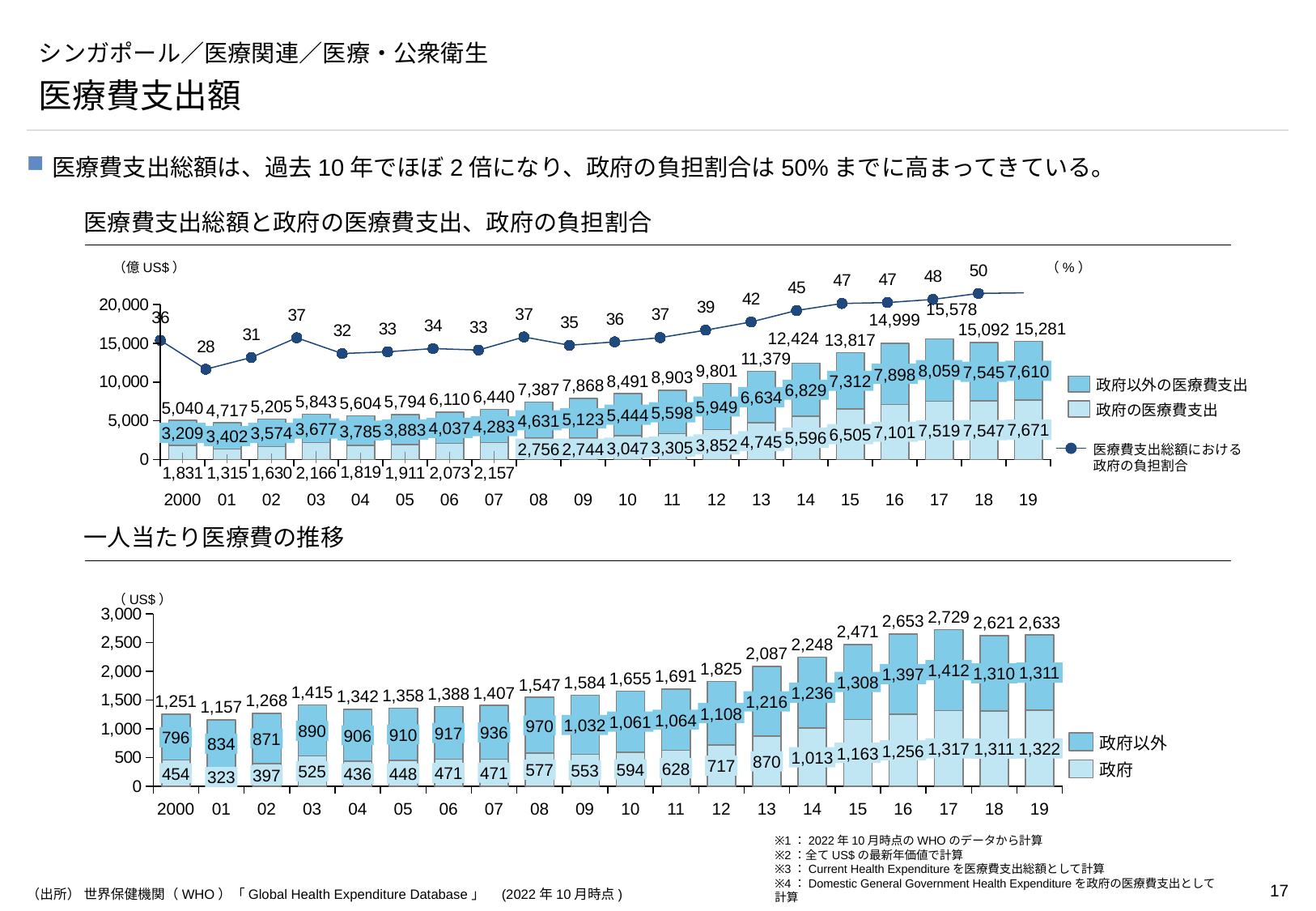
In the bottom chart (一人当たり医療費の推移), what is the per-capita total for 2017? 2,729 In the top chart, which year has the lowest government share on the line? 01 In the top chart, what is the value of 政府の医療費支出 for 2013? 4,745 In the bottom chart, what is the 政府 value for 2012? 717 In the top chart, what is the government share (政府の負担割合) shown for 2001? 28 In the bottom chart, how many years are shown on the x axis? 20 In the bottom chart, which is larger in 2019, 政府以外 or 政府? 政府 What kind of chart is the bottom chart (一人当たり医療費の推移)? Stacked bar chart In the top chart, which year has the highest total health expenditure? 17 In the top chart, how many series does the legend list? 3 In the top chart (医療費支出総額と政府の医療費支出、政府の負担割合), what is the total health expenditure for 2019? 15,281 In the top chart, what is the difference between 政府以外の医療費支出 and 政府の医療費支出 in 2000? 1,378